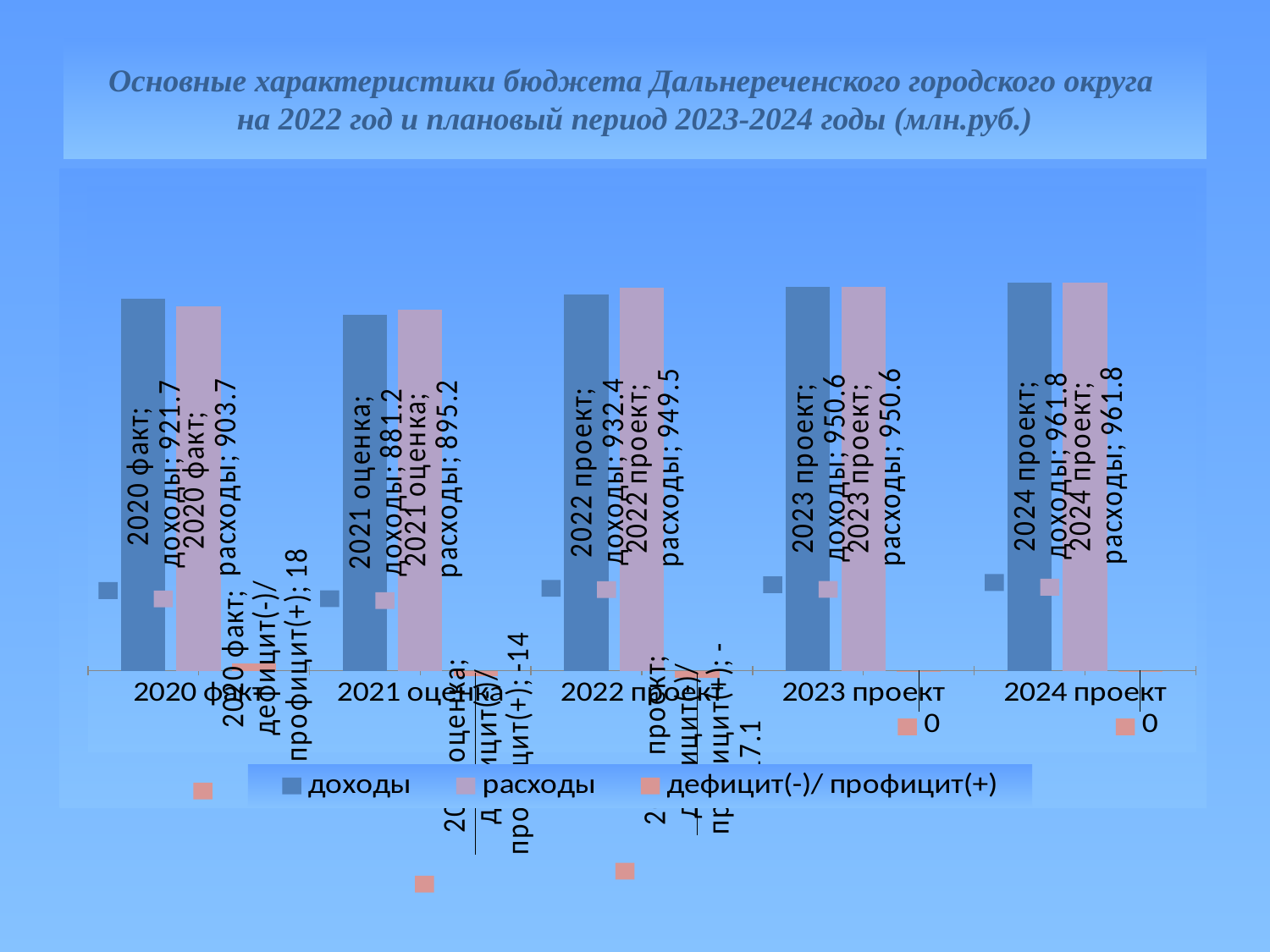
What is the value of дефицит(-)/профицит(+) for 2021 оценка? -14 Which is larger for 2022 проект: доходы or расходы? расходы What is the difference between доходы and расходы for 2020 факт? 18 What is the value of расходы for 2022 проект? 949.5 What is the value of дефицит(-)/профицит(+) for 2020 факт? 18 What is the value of доходы for 2020 факт? 921.7 What is the value of расходы for 2021 оценка? 895.2 How many series does the legend list? 3 Which category has the highest value of доходы? 2024 проект Which category has the lowest value of доходы? 2021 оценка How many categories are shown on the x axis? 5 What type of chart is shown on the slide? bar chart